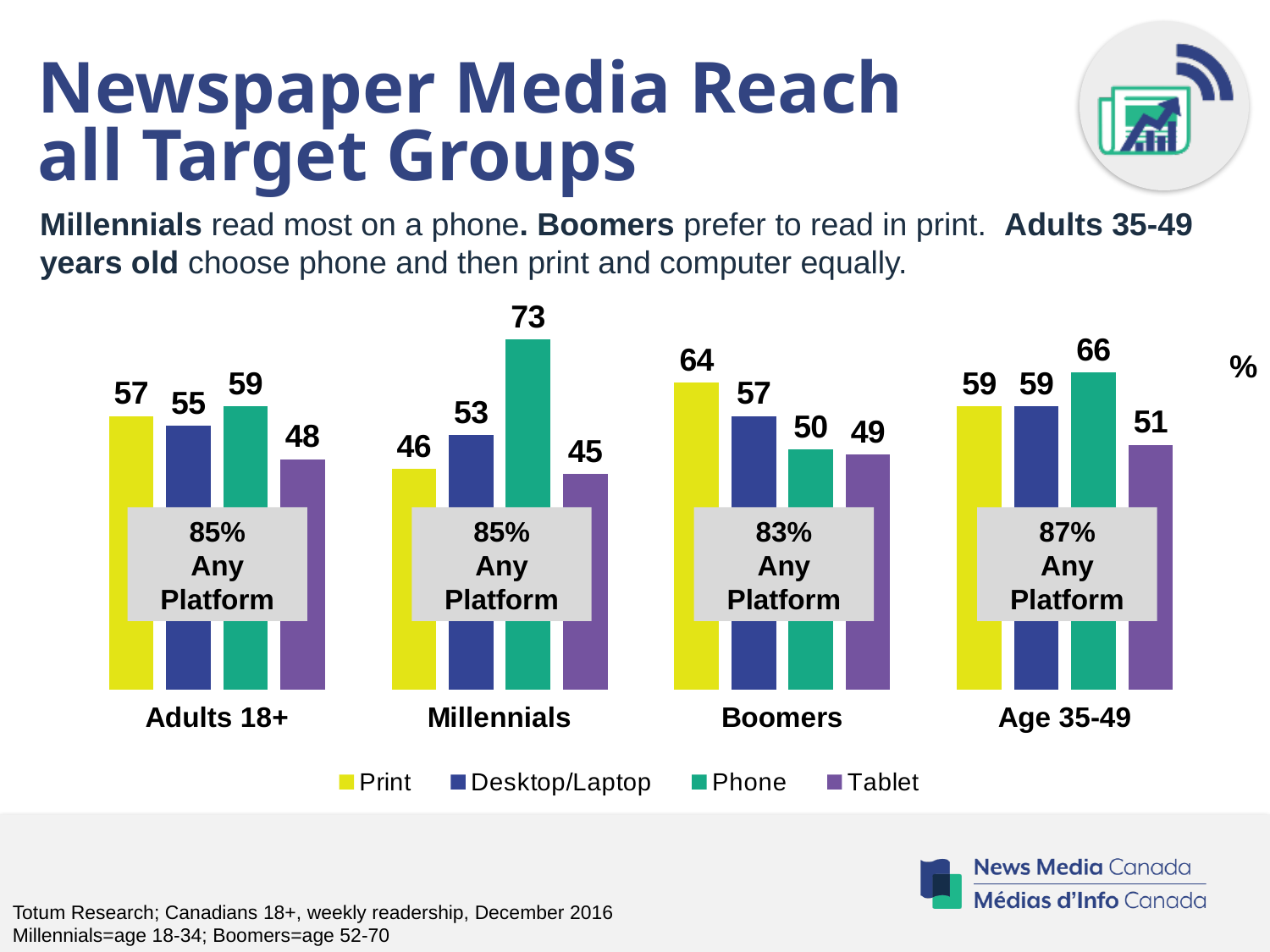
What is the Desktop/Laptop value for Age 35-49? 59 What is the Phone value for Millennials? 73 What is the Print value for Boomers? 64 How many age groups are shown on the x axis? 4 Which is larger for Boomers, Print or Phone? Print What is the difference between the Phone and Print values for Millennials? 27 What is the 'Any Platform' percentage shown for Age 35-49? 87% What is the Tablet value for Adults 18+? 48 Which platform has the highest value for Millennials? Phone Which platform has the lowest value for Boomers? Tablet What kind of chart is shown on the slide? Bar chart How many series does the legend list? 4